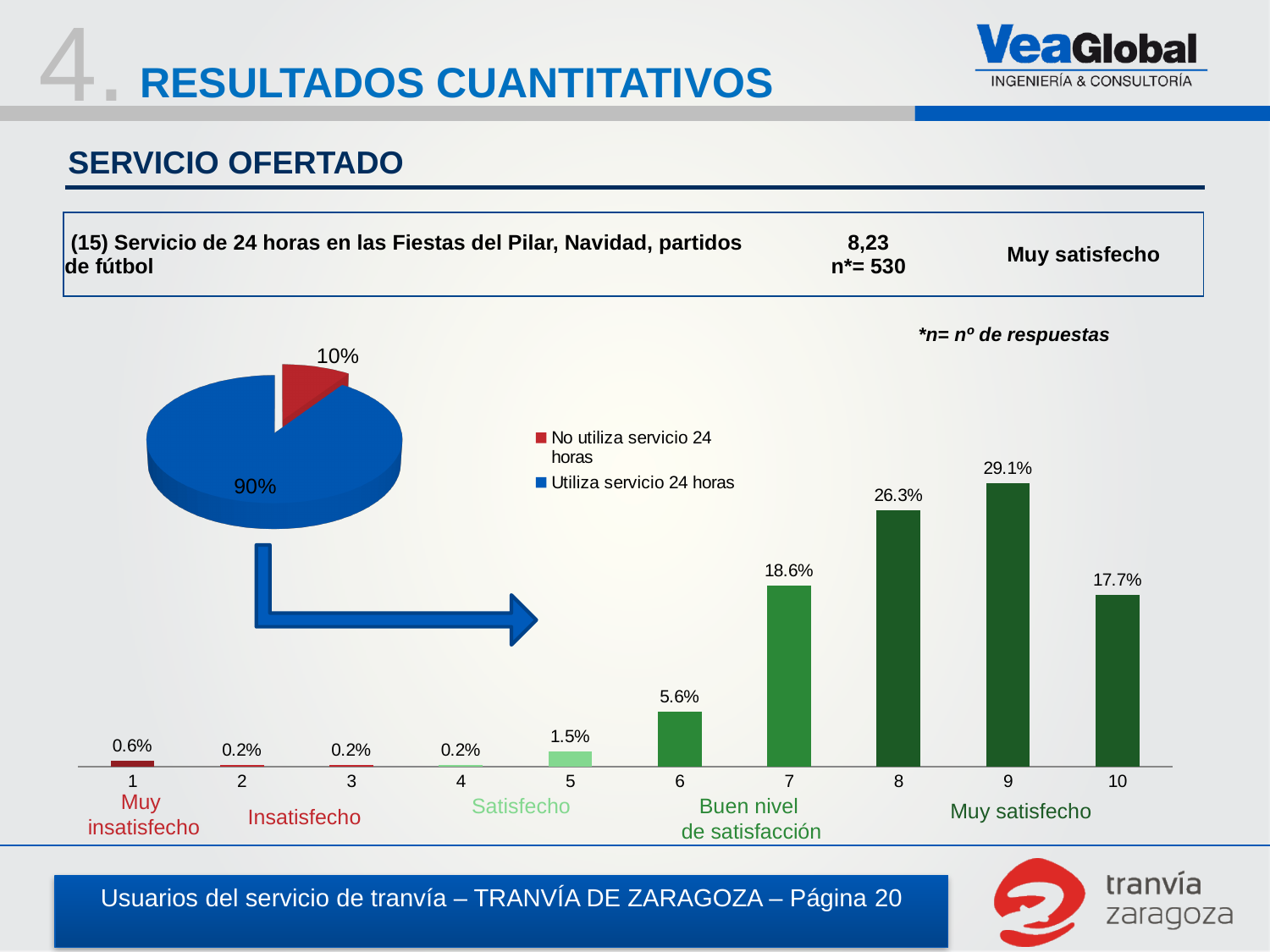
In the pie chart, what percentage corresponds to 'No utiliza servicio 24 horas'? 10% In the bar chart, what is the difference between the values for categories 8 and 10? 8.6% In the bar chart, what is the combined value of categories 8 and 9? 55.4% In the bar chart, what is the value for category 9? 29.1% How many entries does the legend of the pie chart list? 2 In the pie chart, what share of respondents use the 24-hour service (Utiliza servicio 24 horas)? 90% In the bar chart, which category has the highest value? 9 In the pie chart, which colour represents 'Utiliza servicio 24 horas'? Blue In the bar chart, what is the value for category 7? 18.6% How many categories are shown on the x axis of the bar chart? 10 What type of chart is the one at the bottom of the slide showing satisfaction levels 1 to 10? Bar chart In the bar chart, which is larger, the value for category 6 or the value for category 10? 10